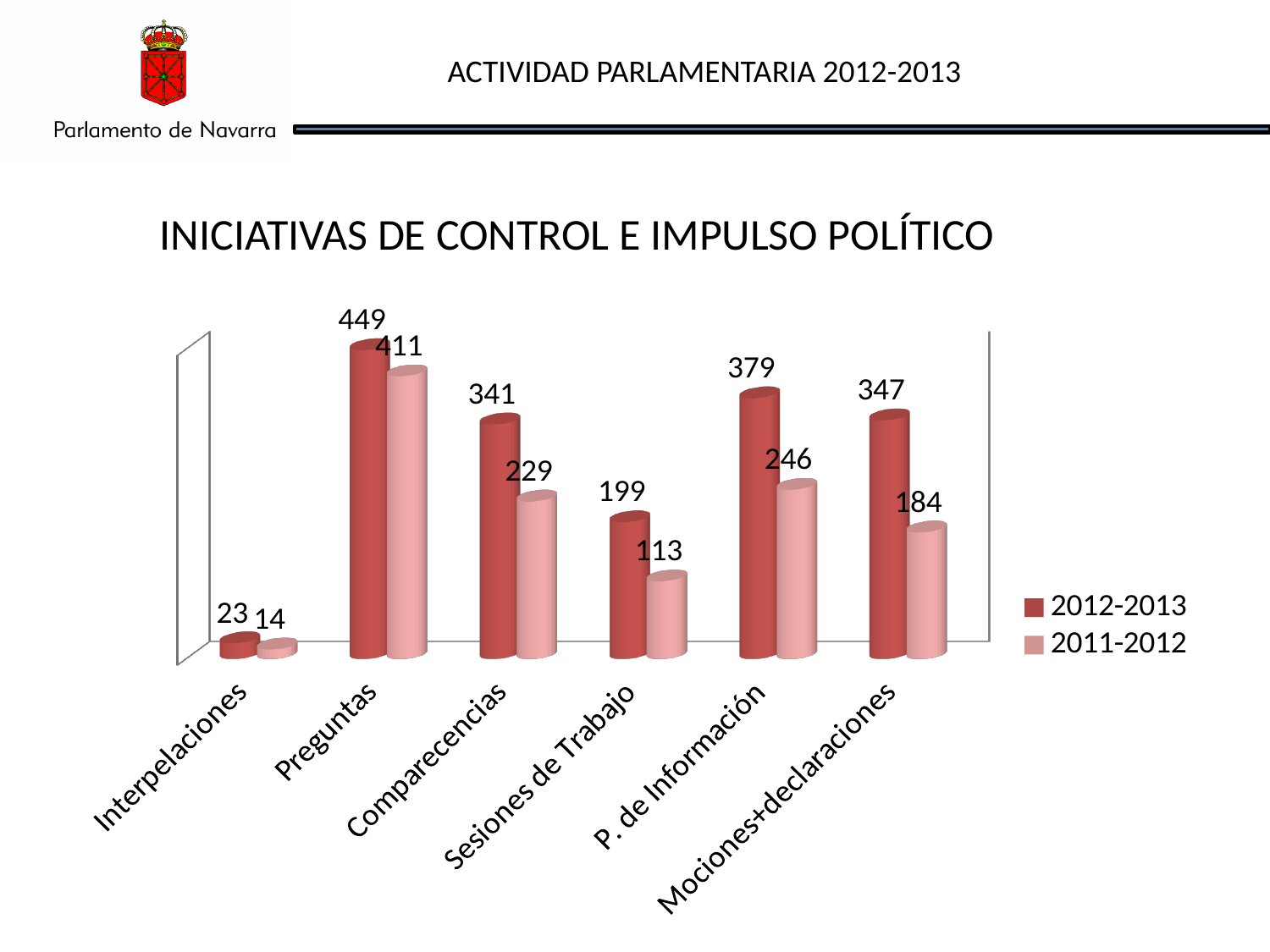
What is the value for Preguntas in the 2012-2013 series? 449 What is the value for Mociones+declaraciones in the 2011-2012 series? 184 What kind of chart is shown on the slide? Bar chart Which is larger for Comparecencias: the 2012-2013 value or the 2011-2012 value? 2012-2013 How many series does the legend list? 2 What is the difference between the 2012-2013 and 2011-2012 values for P. de Información? 133 Which category has the highest value in the 2012-2013 series? Preguntas What is the value for Sesiones de Trabajo in the 2012-2013 series? 199 Which category has the lowest value in the 2011-2012 series? Interpelaciones How many categories are shown on the x axis? 6 What is the title of the chart? INICIATIVAS DE CONTROL E IMPULSO POLÍTICO What is the value for Comparecencias in the 2011-2012 series? 229